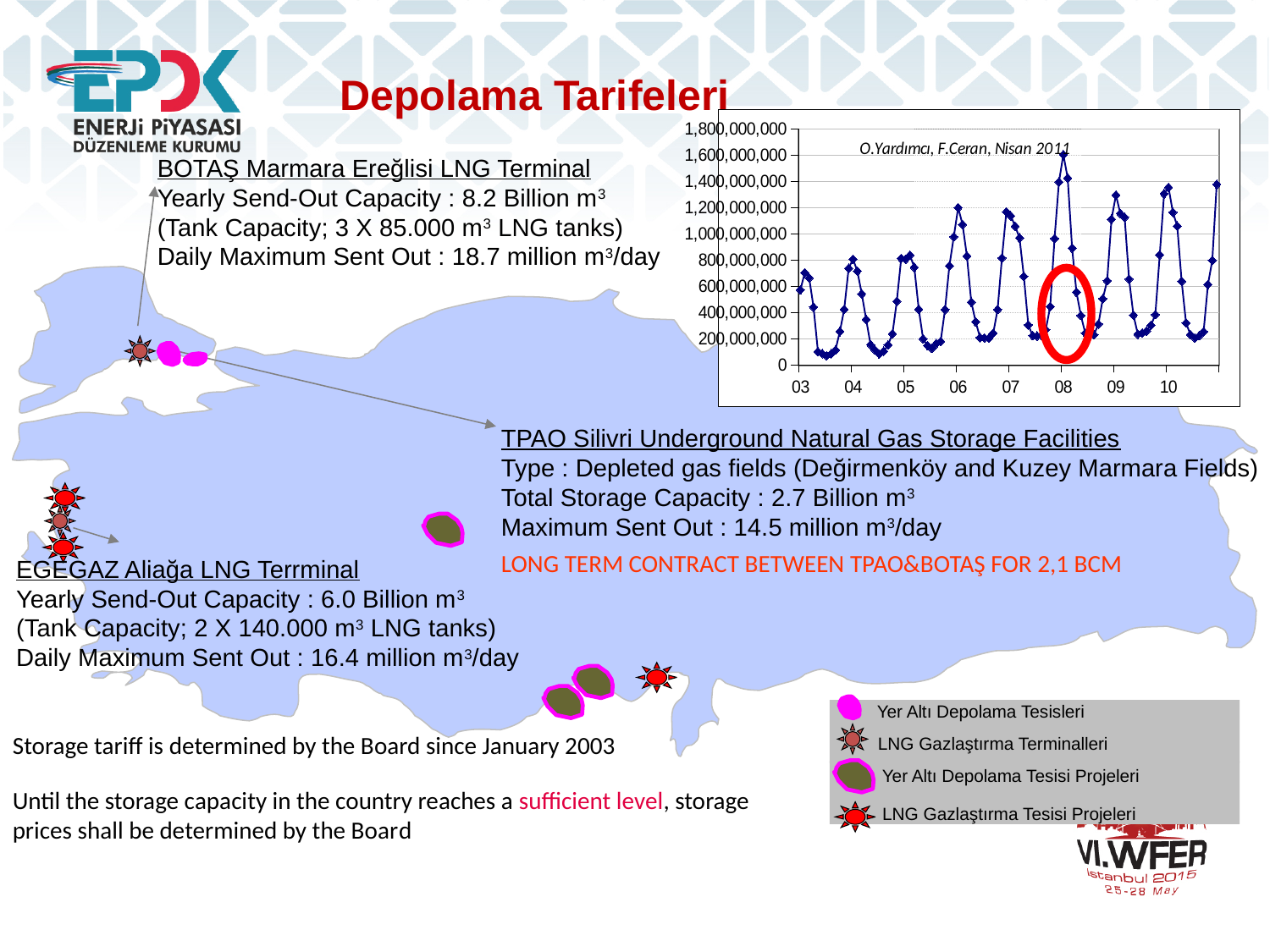
Is the highest peak of the line in 08 greater or less than 1,400,000,000? greater Is the peak of the line in 06 greater or less than 1,000,000,000? greater What is the highest value shown on the y axis of the chart? 1,800,000,000 Is the lowest point of the line in 03 greater or less than 200,000,000? less In which year does the line reach its highest peak? 08 Which year has the higher peak on the line, 08 or 09? 08 What is the last year label on the x axis of the chart? 10 Does the line show a steady rise, a steady fall, or a repeating seasonal pattern of peaks and troughs across the years? repeating seasonal pattern of peaks and troughs What kind of chart is shown on the slide? line chart What is the first year label on the x axis of the chart? 03 How many year labels are shown on the x axis of the chart? 8